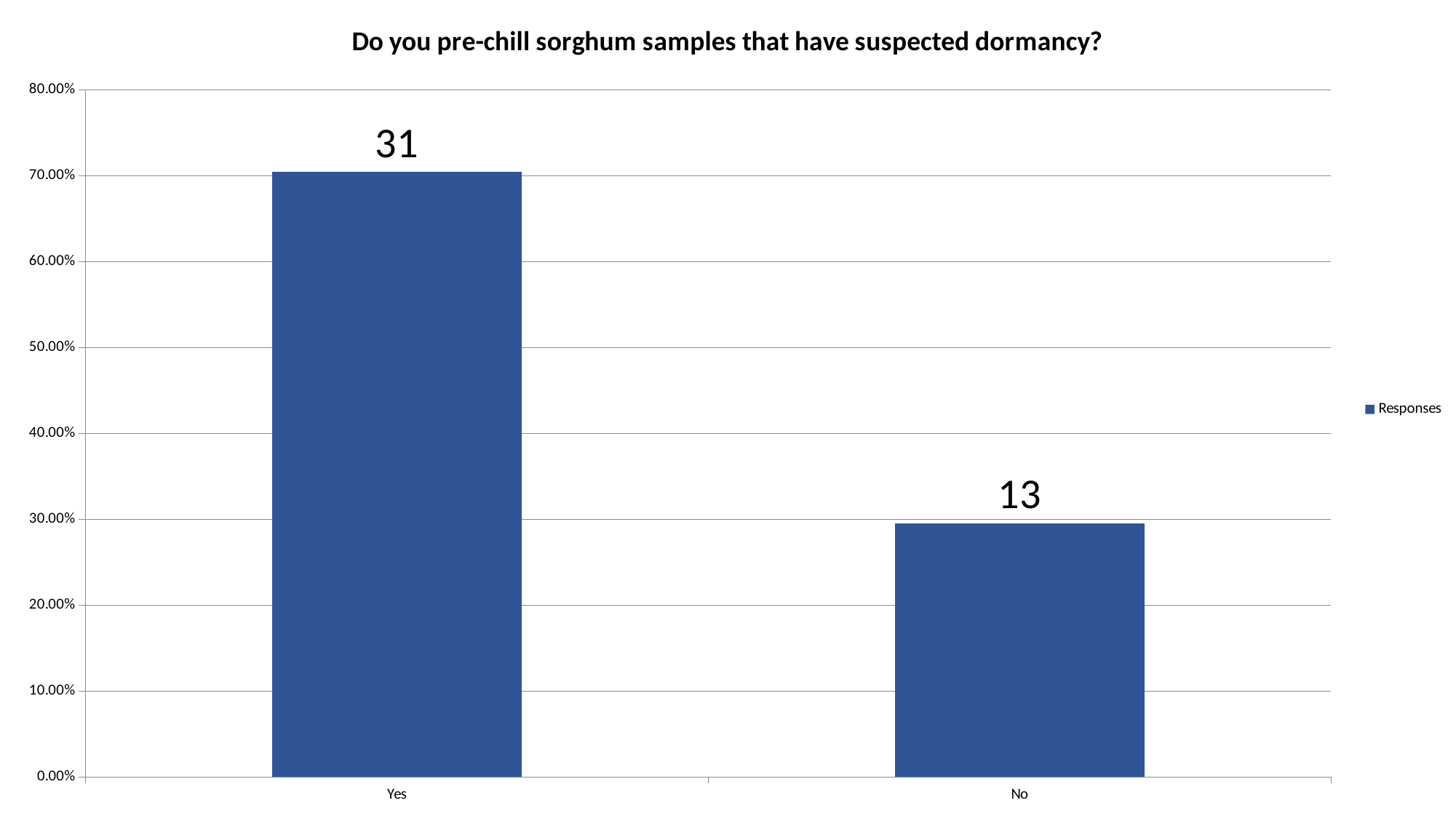
What type of chart is shown on the slide? bar chart How many categories are shown on the x axis? 2 Is the bar for No greater or less than 40.00% on the axis? less Which category has the lowest bar? No What is the title of the chart? Do you pre-chill sorghum samples that have suspected dormancy? Is the bar for Yes greater or less than 60.00% on the axis? greater What is the data label shown on the No bar? 13 What is the difference between the data labels for Yes and No? 18 How many series does the legend list? 1 What is the data label shown on the Yes bar? 31 Which is larger, the value for Yes or the value for No? Yes Which category has the highest bar? Yes